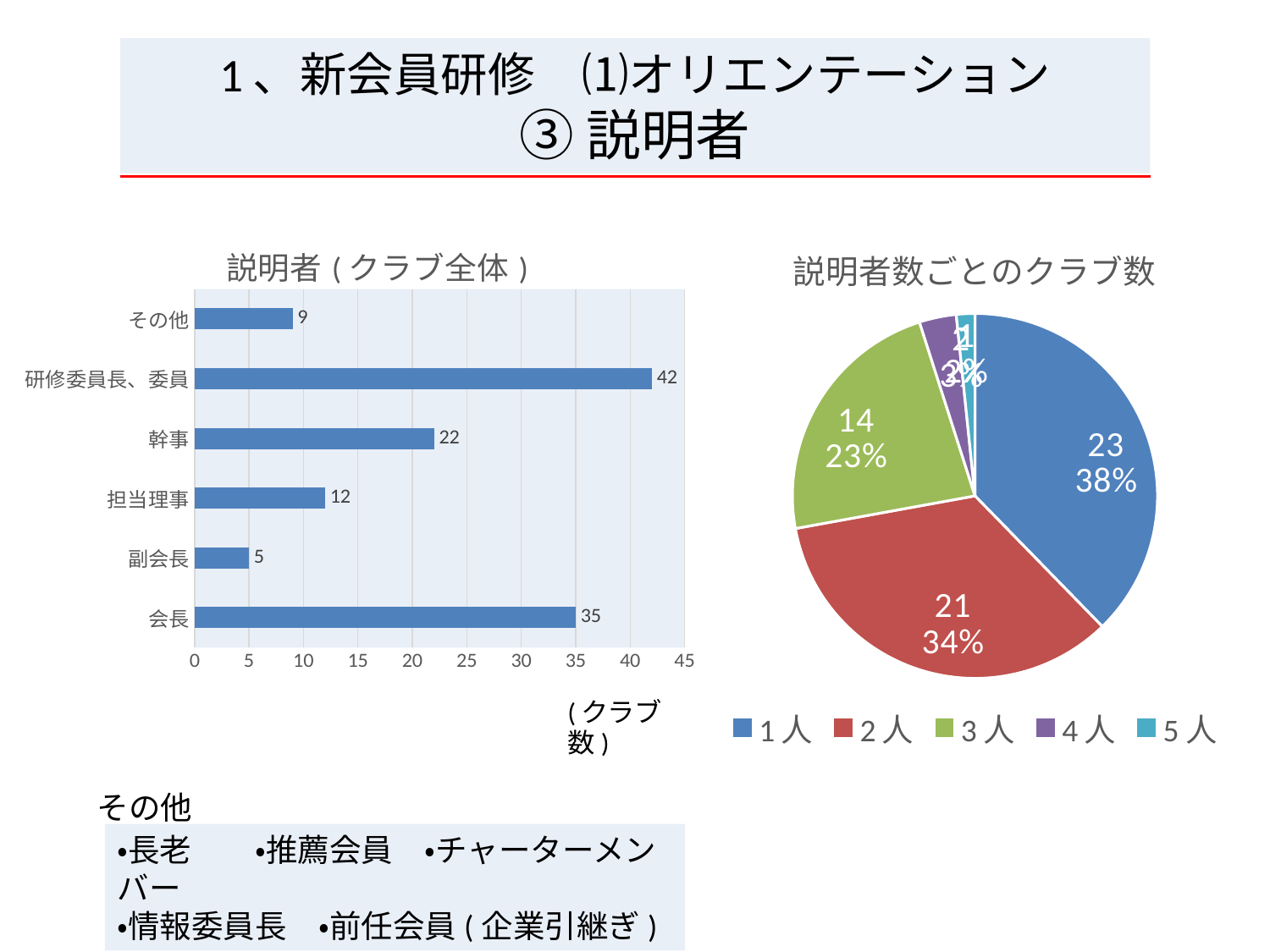
In the bar chart titled 説明者(クラブ全体), what is the difference between the values for 幹事 and 担当理事? 10 In the bar chart titled 説明者(クラブ全体), how many categories are shown? 6 In the bar chart titled 説明者(クラブ全体), which category has the lowest value? 副会長 In the pie chart titled 説明者数ごとのクラブ数, which slice is the largest? 1人 In the pie chart titled 説明者数ごとのクラブ数, what share does the 1人 slice represent? 38% In the bar chart titled 説明者(クラブ全体), which is larger, the value for 会長 or the value for 幹事? 会長 In the bar chart titled 説明者(クラブ全体), what is the value for 研修委員長、委員? 42 In the bar chart titled 説明者(クラブ全体), what is the value for 会長? 35 What kind of chart is the chart titled 説明者(クラブ全体)? bar chart In the bar chart titled 説明者(クラブ全体), which category has the highest value? 研修委員長、委員 In the pie chart titled 説明者数ごとのクラブ数, what is the value for 3人? 14 In the pie chart titled 説明者数ごとのクラブ数, how many entries does the legend list? 5